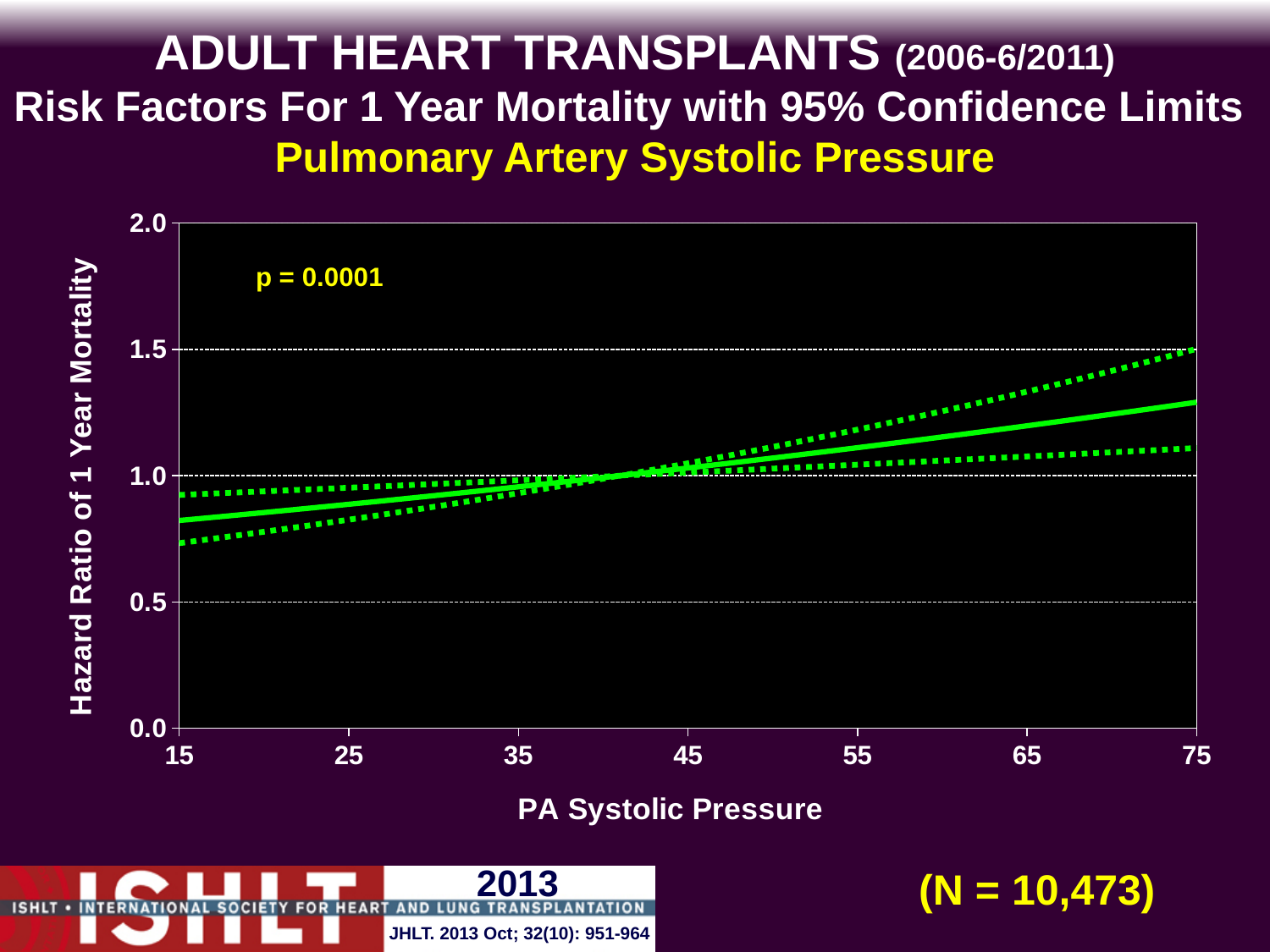
Is the hazard ratio (solid line) at a PA systolic pressure of 15 greater or less than 1.0? less Is the hazard ratio (solid line) higher at a PA systolic pressure of 75 or at 15? 75 What is the label of the x axis? PA Systolic Pressure Does the hazard ratio (solid line) rise or fall as PA systolic pressure increases from 15 to 75? rise Is the lower 95% confidence limit at a PA systolic pressure of 15 greater or less than 0.5? greater How many lines are plotted on the chart? 3 What kind of chart is shown on the slide? line chart Is the hazard ratio (solid line) at a PA systolic pressure of 75 greater or less than 1.0? greater What is the p-value shown on the chart? p = 0.0001